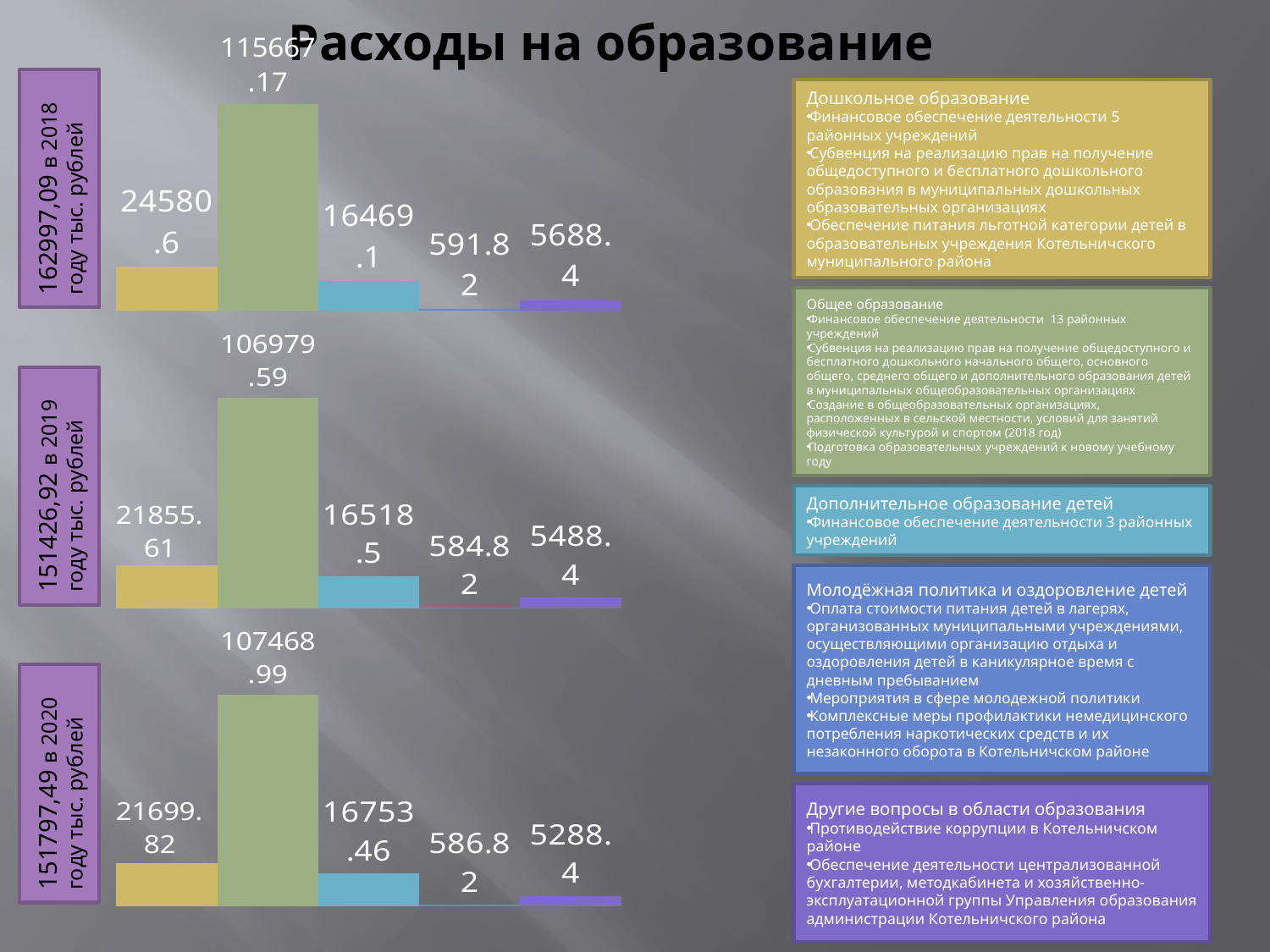
In the 2018 chart, what is the difference between the yellow bar (24580.6) and the blue bar (16469.1)? 8111.5 In the 2019 chart (151426,92 в 2019 году тыс. рублей), what is the value of the first (yellow) bar? 21855.61 What is the difference between the purple bar in the 2019 chart (5488.4) and the purple bar in the 2020 chart (5288.4)? 200 In the 2018 chart, which bar has the lowest value? 591.82 Which is larger: the green bar in the 2018 chart or the green bar in the 2019 chart? 2018 chart (115667.17) In the 2019 chart, which bar has the highest value? 106979.59 What is the title of the slide? Расходы на образование How many bars are plotted in the 2020 chart? 5 What type of chart is used for each year on this slide? Bar chart In the 2020 chart (151797,49 в 2020 году тыс. рублей), what is the value of the last (purple) bar? 5288.4 In the 2018 chart (162997,09 в 2018 году тыс. рублей), what is the value of the tallest (green) bar? 115667.17